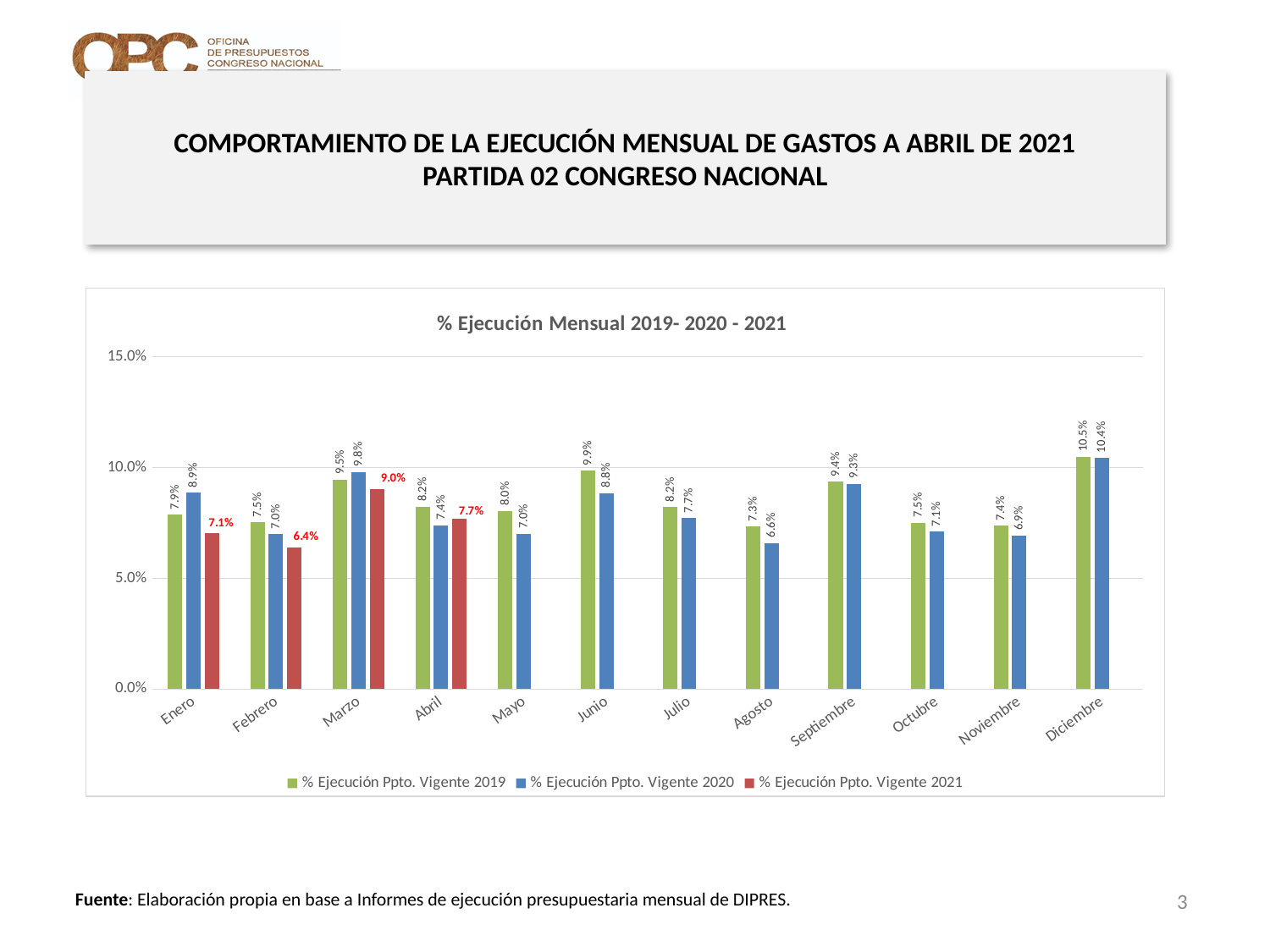
Is the value for % Ejecución Ppto. Vigente 2021 in Febrero greater or less than 5.0%? greater What type of chart is shown on the slide? bar chart What is the difference between the 2019 and 2020 values in Abril? 0.8% What is the value for % Ejecución Ppto. Vigente 2020 in Junio? 8.8% How many months are shown on the x axis? 12 Which month has the lowest value for % Ejecución Ppto. Vigente 2020? Agosto In Enero, which is larger: the 2019 value or the 2020 value? 2020 What is the title of the chart? % Ejecución Mensual 2019- 2020 - 2021 What is the value for % Ejecución Ppto. Vigente 2021 in Marzo? 9.0% Which month has the highest value for % Ejecución Ppto. Vigente 2019? Diciembre How many series does the legend list? 3 What is the value for % Ejecución Ppto. Vigente 2019 in Diciembre? 10.5%